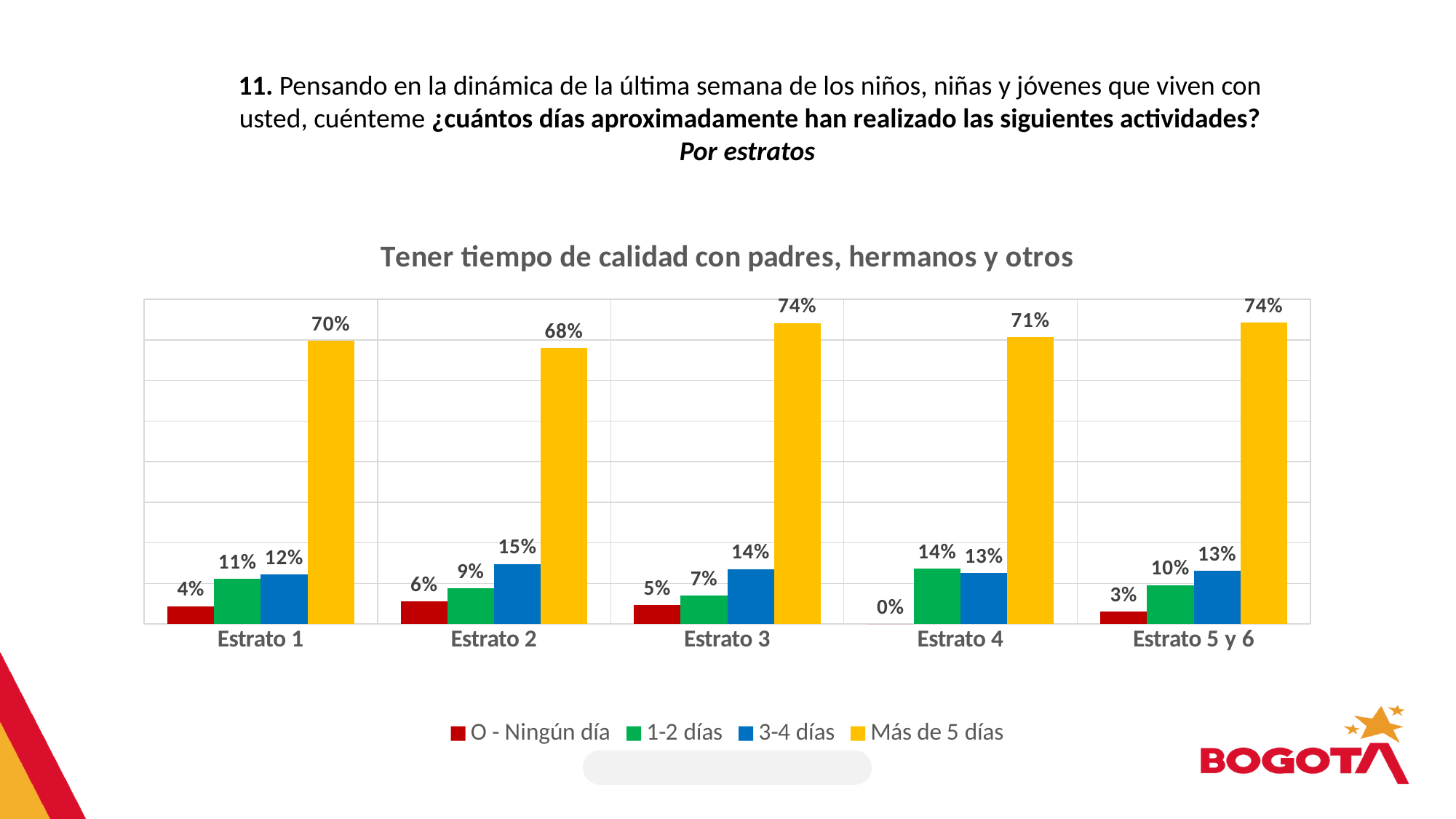
Which estrato has the highest value for '0 - Ningún día'? Estrato 2 What is the value for 'Más de 5 días' in Estrato 3? 74% How many estrato categories are shown on the x axis? 5 What is the value for '3-4 días' in Estrato 2? 15% What kind of chart is shown on the slide? Bar chart Which estrato has the lowest value for 'Más de 5 días'? Estrato 2 How many series does the legend list? 4 What is the value for '0 - Ningún día' in Estrato 4? 0% What is the difference between the 'Más de 5 días' values for Estrato 3 and Estrato 1? 4% Which is larger in Estrato 4: the value for '1-2 días' or '3-4 días'? 1-2 días What is the value for '1-2 días' in Estrato 5 y 6? 10% What is the title of the chart? Tener tiempo de calidad con padres, hermanos y otros